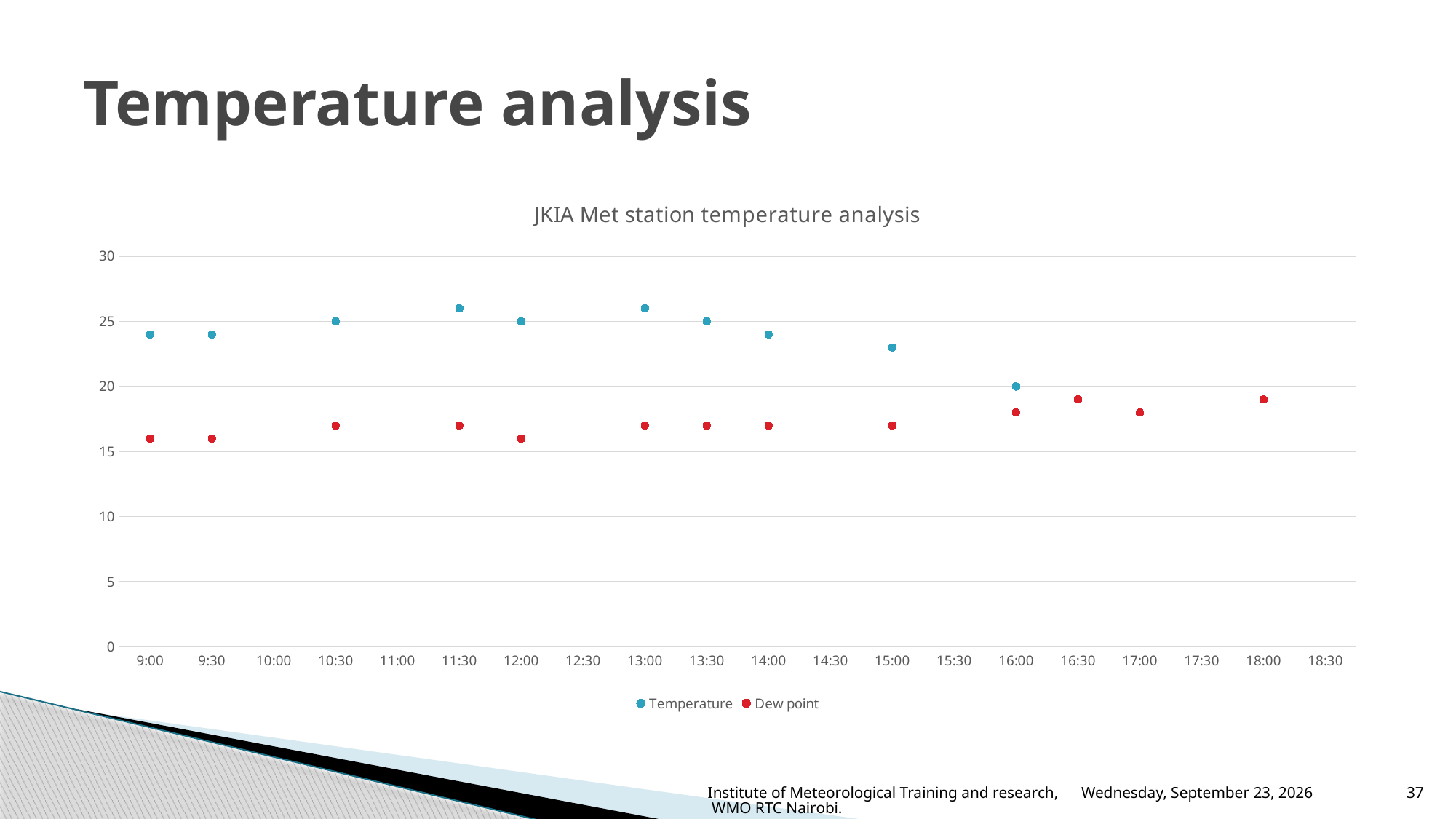
What kind of chart is shown on the slide? Scatter chart Does the Temperature rise or fall between 13:00 and 16:00? Fall At 9:00, which is larger, the Temperature or the Dew point? Temperature Which series is plotted with red markers? Dew point How many series does the legend list? 2 Is the Temperature value at 11:30 greater or less than 25? greater What is the Temperature value at 10:30? 25 How many Dew point points are plotted? 13 What is the Temperature value at 16:00? 20 What is the title of the chart? JKIA Met station temperature analysis Is the Dew point value at 9:00 greater or less than 20? less